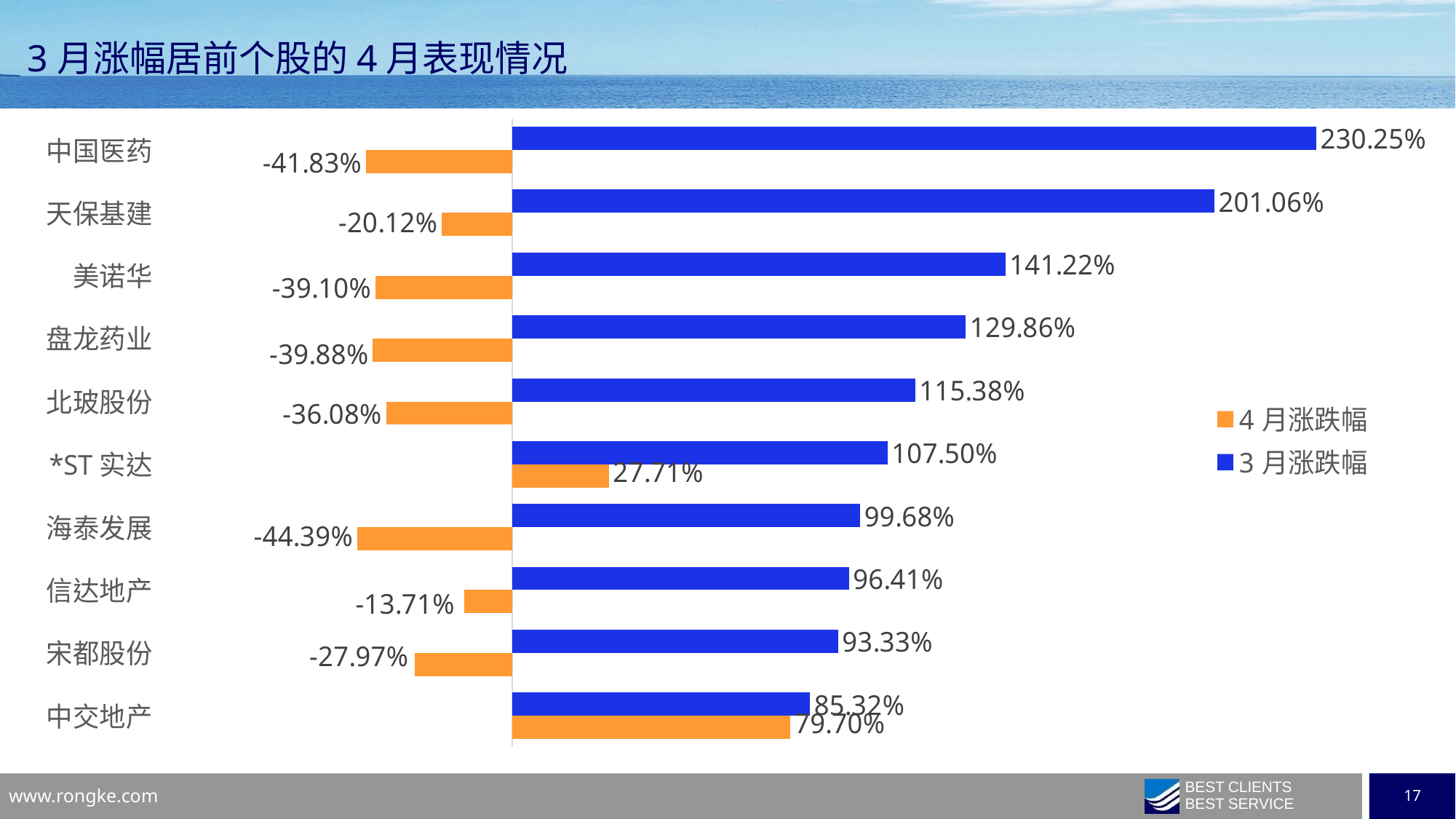
How many stocks are shown in the chart? 10 Which stock has the lowest 4月涨跌幅? 海泰发展 What is the 4月涨跌幅 value for *ST实达? 27.71% What is the difference between the 3月涨跌幅 of 中国医药 and 天保基建? 29.19% Which stock has the highest 3月涨跌幅? 中国医药 What is the 4月涨跌幅 value for 海泰发展? -44.39% What type of chart is shown on the slide? Bar chart Which colour represents 4月涨跌幅 in the chart? Orange Which is larger, the 3月涨跌幅 of 美诺华 or of 盘龙药业? 美诺华 How many series does the legend list? 2 Which stock has the highest 4月涨跌幅? 中交地产 What is the 3月涨跌幅 value for 中国医药? 230.25%